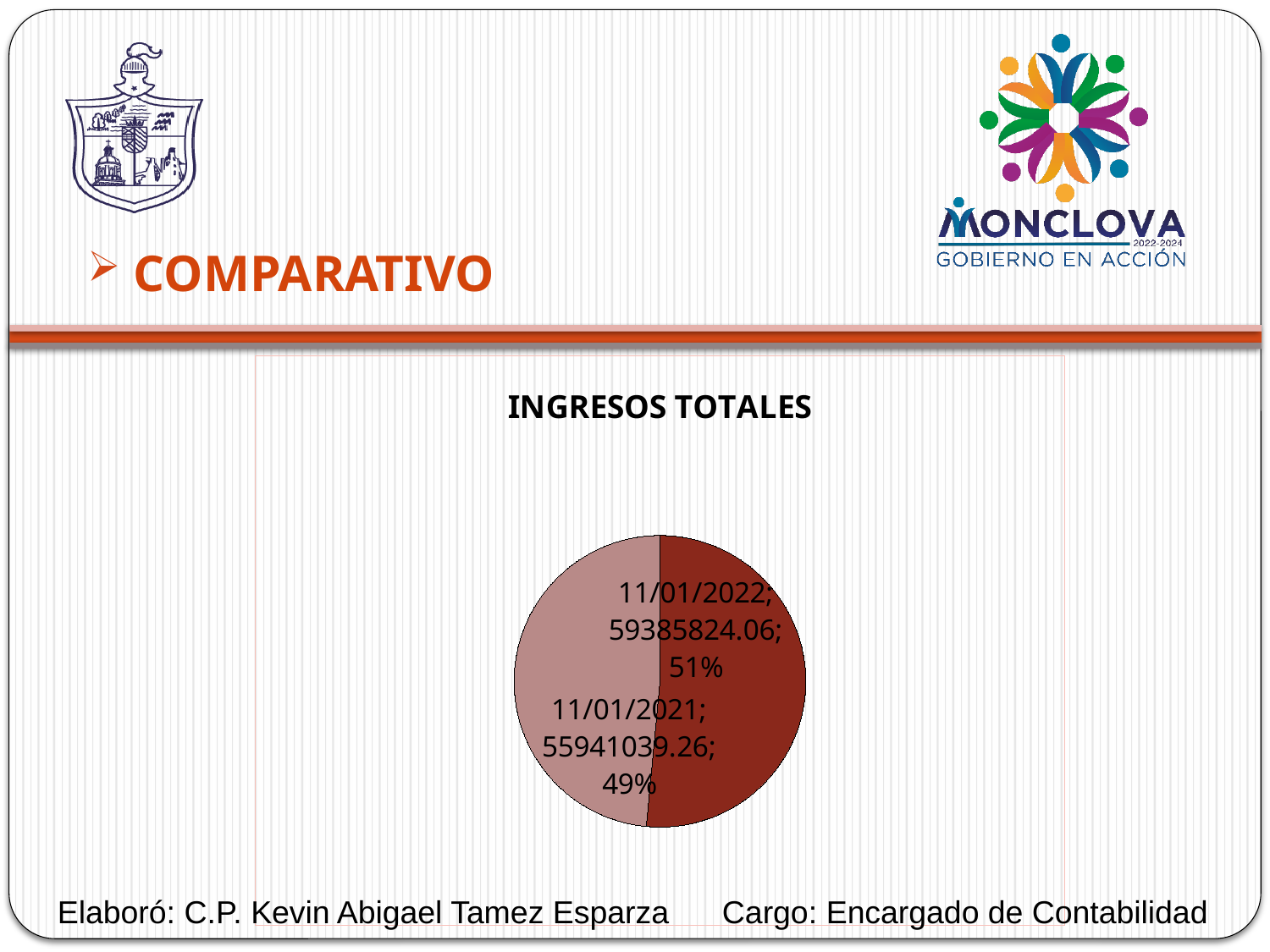
Which slice is the largest in the pie chart? 11/01/2022 What is the value shown for 11/01/2022? 59385824.06 What share of the pie does the 11/01/2021 slice represent? 49% What share of the pie does the 11/01/2022 slice represent? 51% What type of chart is shown under the title INGRESOS TOTALES? pie chart Which slice is the smallest in the pie chart? 11/01/2021 What is the title of the chart? INGRESOS TOTALES What is the total of the two values shown in the pie chart? 115326863.32 What is the difference between the value for 11/01/2022 and the value for 11/01/2021? 3444784.80 Which is larger, the value for 11/01/2022 or the value for 11/01/2021? 11/01/2022 What is the value shown for 11/01/2021? 55941039.26 How many slices does the pie chart have? 2